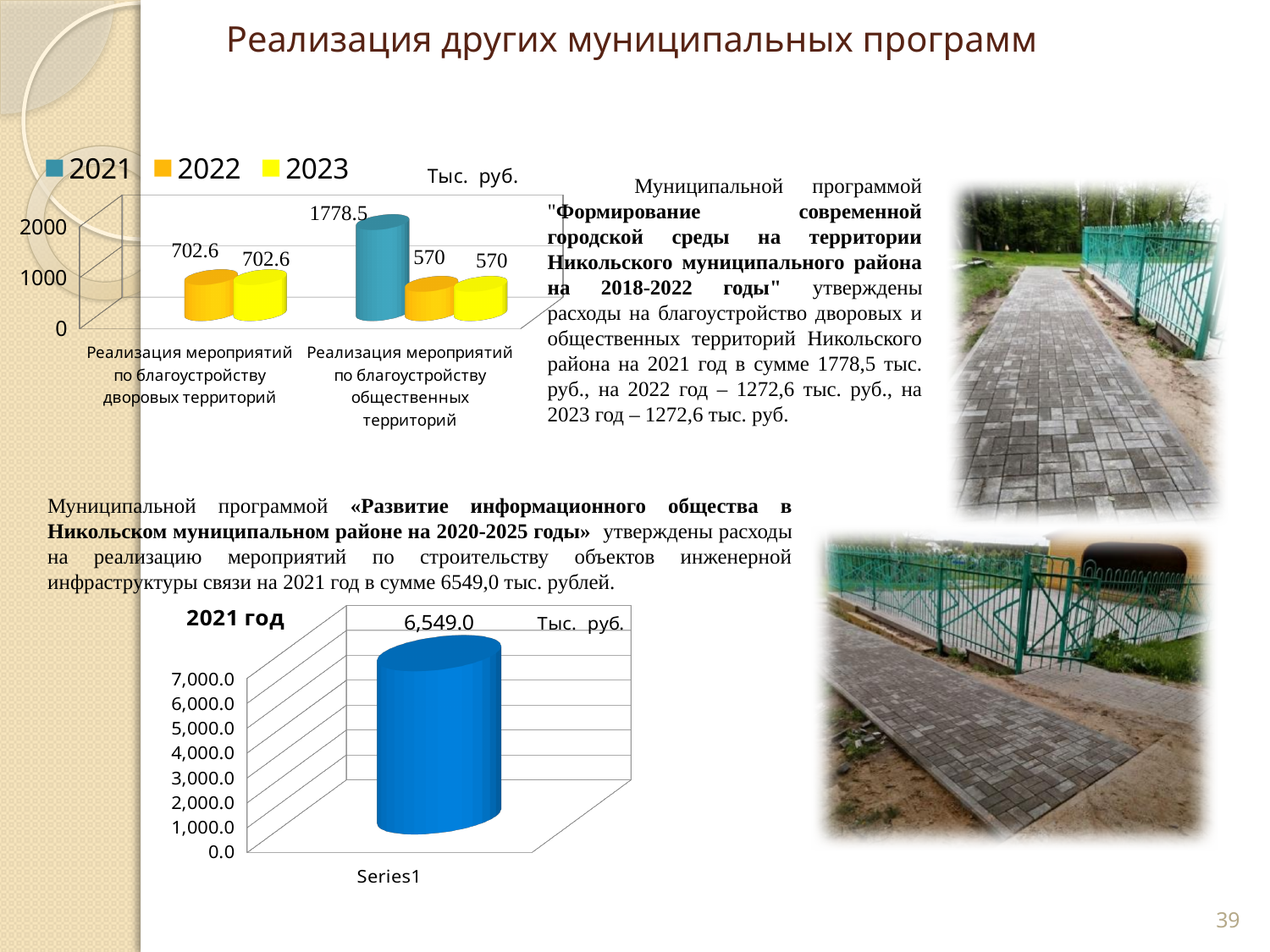
In the bottom chart titled '2021 год', what is the value of the single bar? 6,549.0 In the top-left chart, what is the difference between the 2021 and 2022 values for 'Реализация мероприятий по благоустройству общественных территорий'? 1208.5 In the top-left chart, is the 2021 value for общественных территорий greater or less than 1000? greater In the top-left chart, what is the 2021 value for 'Реализация мероприятий по благоустройству общественных территорий'? 1778.5 In the bottom chart titled '2021 год', what is the series name shown on the x axis? Series1 In the top-left chart, which is larger: the 2022 value for дворовых территорий or the 2022 value for общественных территорий? 2022 value for дворовых территорий (702.6) In the top-left chart, what is the 2022 value for 'Реализация мероприятий по благоустройству дворовых территорий'? 702.6 In the top-left chart, what is the 2023 value for 'Реализация мероприятий по благоустройству общественных территорий'? 570 In the top-left chart, what unit is indicated next to the legend? Тыс. руб. What kind of chart is the top-left chart? bar chart In the top-left chart, how many series does the legend list? 3 In the top-left chart, how many categories are shown on the x axis? 2